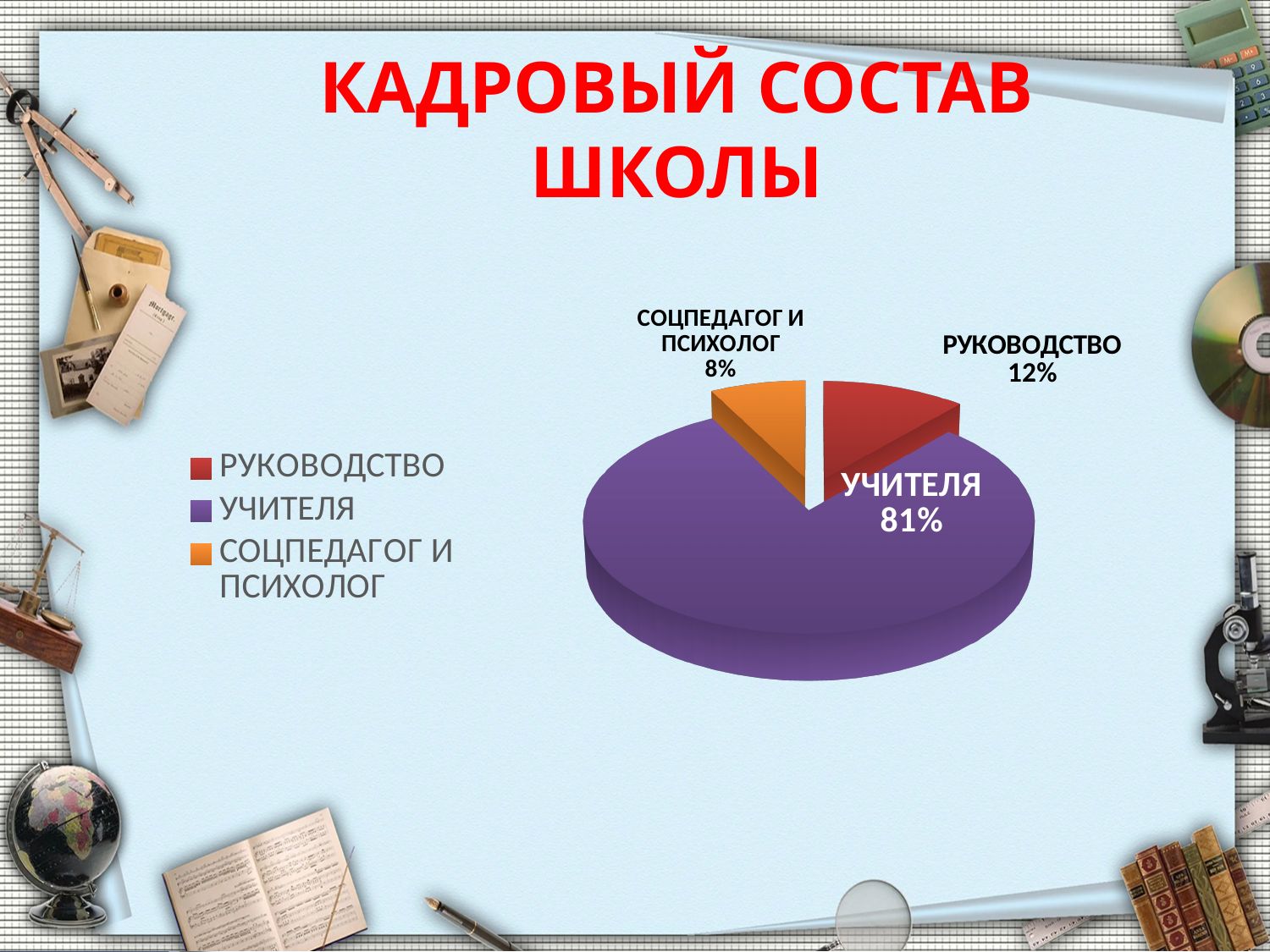
What is the difference in percentage points between РУКОВОДСТВО and СОЦПЕДАГОГ И ПСИХОЛОГ? 4 Which category has the smallest slice of the pie? СОЦПЕДАГОГ И ПСИХОЛОГ What kind of chart is shown on the slide? pie chart What share of the pie does УЧИТЕЛЯ have? 81% Which is larger, the share for РУКОВОДСТВО or the share for СОЦПЕДАГОГ И ПСИХОЛОГ? РУКОВОДСТВО What is the difference in percentage points between УЧИТЕЛЯ and РУКОВОДСТВО? 69 What share of the pie does РУКОВОДСТВО have? 12% Which category has the largest slice of the pie? УЧИТЕЛЯ What share of the pie does СОЦПЕДАГОГ И ПСИХОЛОГ have? 8% What is the title of the slide containing the chart? КАДРОВЫЙ СОСТАВ ШКОЛЫ What colour is the slice for УЧИТЕЛЯ? purple How many categories does the pie chart have? 3